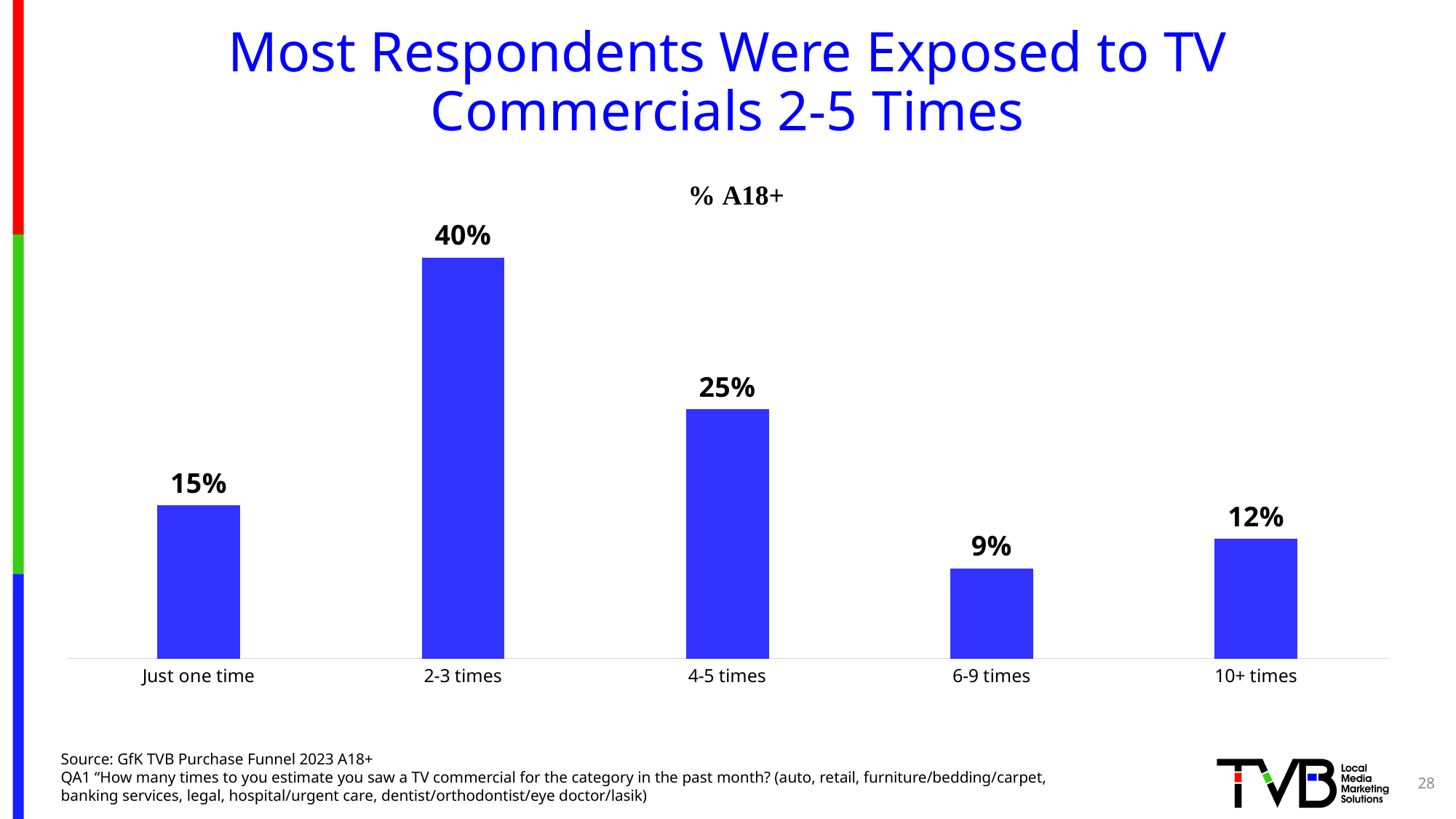
What is the difference between the values for "2-3 times" and "4-5 times"? 15% What is the title shown above the chart's plot area? % A18+ Which category has the highest value? 2-3 times What is the difference between the values for "Just one time" and "10+ times"? 3% What percentage of respondents were exposed to TV commercials 2-3 times? 40% Which is larger, the value for "4-5 times" or the value for "Just one time"? 4-5 times What is the value shown for "10+ times"? 12% Which category has the lowest value? 6-9 times What is the value for the "Just one time" category? 15% What kind of chart is shown on the slide? Bar chart What percentage of respondents saw a TV commercial 6-9 times? 9% How many categories are shown on the x axis? 5